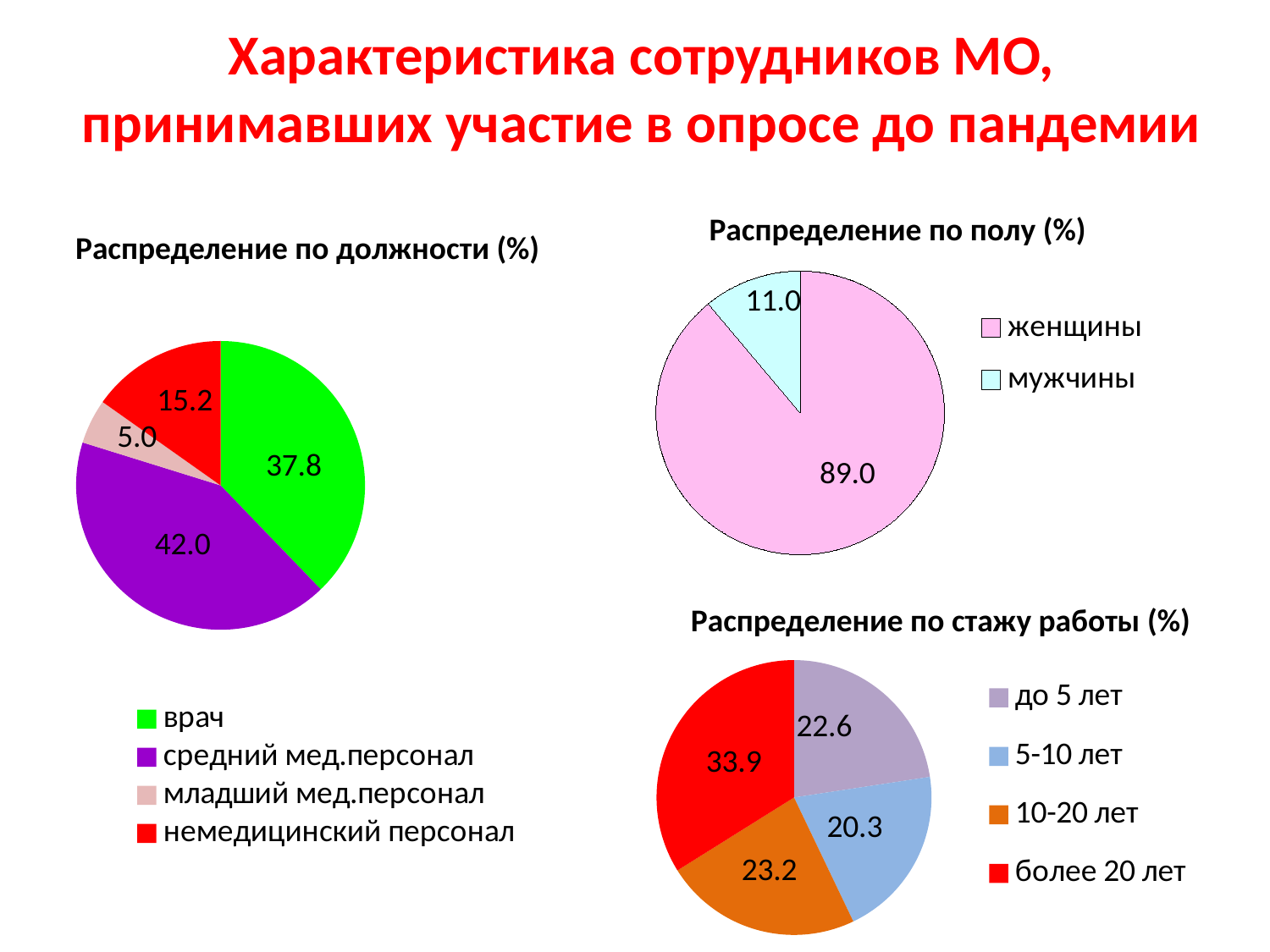
In the chart 'Распределение по должности (%)', how many categories does the legend list? 4 In the chart 'Распределение по стажу работы (%)', what is the difference between the values for 'более 20 лет' and 'до 5 лет'? 11.3 In the chart 'Распределение по должности (%)', which category has the smallest slice? младший мед.персонал In the chart 'Распределение по стажу работы (%)', what is the value for '10-20 лет'? 23.2 In the chart 'Распределение по должности (%)', what is the difference between the values for 'врач' and 'немедицинский персонал'? 22.6 In the chart 'Распределение по стажу работы (%)', which category has the smallest slice? 5-10 лет What type of chart is 'Распределение по полу (%)'? pie chart In the chart 'Распределение по полу (%)', which category is larger, 'женщины' or 'мужчины'? женщины How many pie charts are shown on the slide? 3 In the chart 'Распределение по стажу работы (%)', which category has the largest slice? более 20 лет In the chart 'Распределение по должности (%)', what is the value for 'средний мед.персонал'? 42.0 In the chart 'Распределение по полу (%)', what is the value for 'мужчины'? 11.0